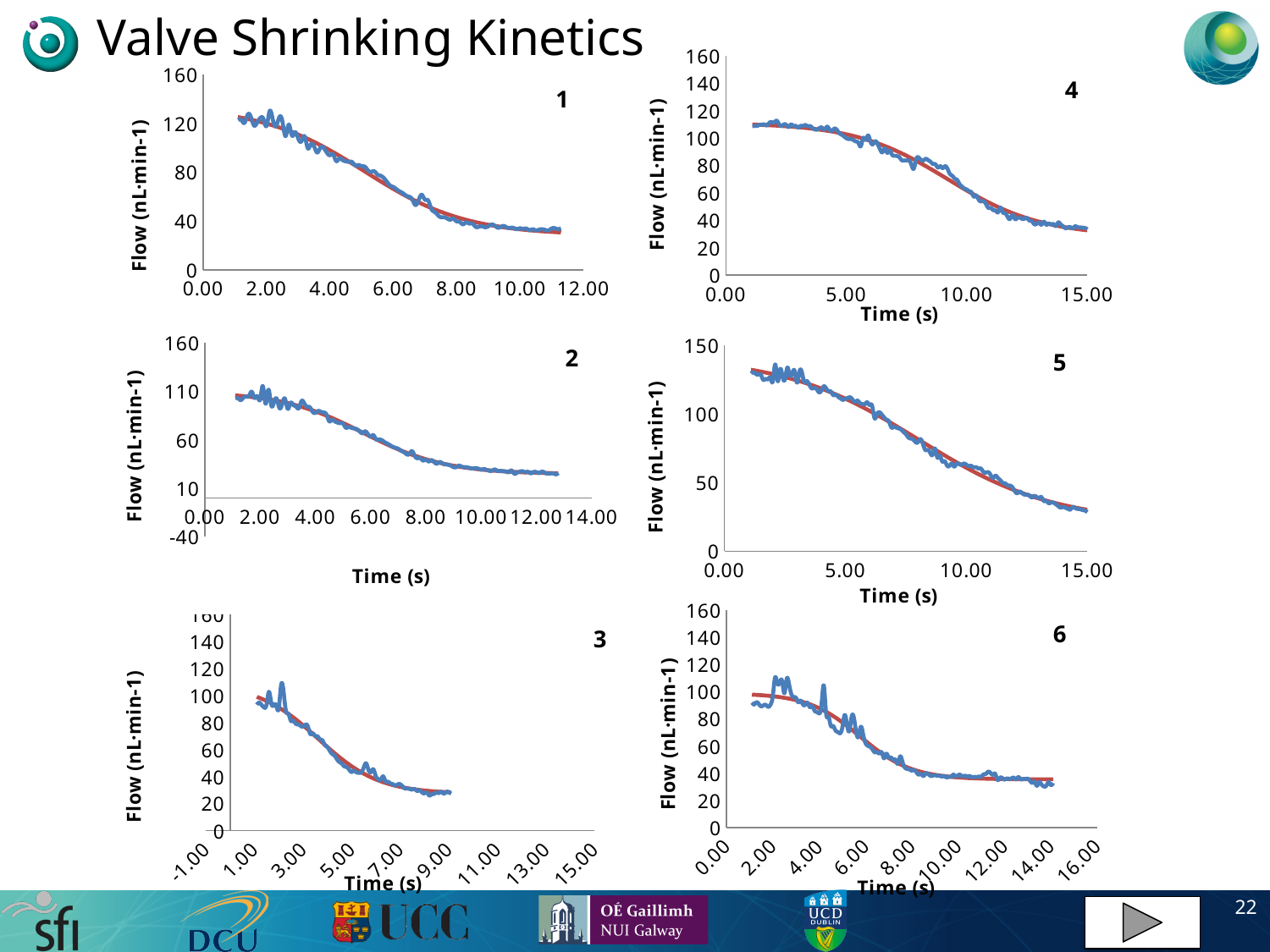
In chart 1, do the flow values rise or fall as time increases? fall In chart 4, is the flow value at about 15.00 s greater or less than 60? less What is the title of the slide containing the charts? Valve Shrinking Kinetics How many charts are shown on the slide? 6 What is the y-axis label on chart 4? Flow (nL·min-1) In chart 5, do the flow values rise or fall along the time axis? fall In chart 6, is the flow value at about 2.00 s greater or less than 60? greater In chart 3, is the flow value at about 9.00 s greater or less than 60? less What type of chart is chart 1 (top left)? line chart In chart 1, which is larger: the flow at about 2.00 s or the flow at about 10.00 s? the flow at about 2.00 s